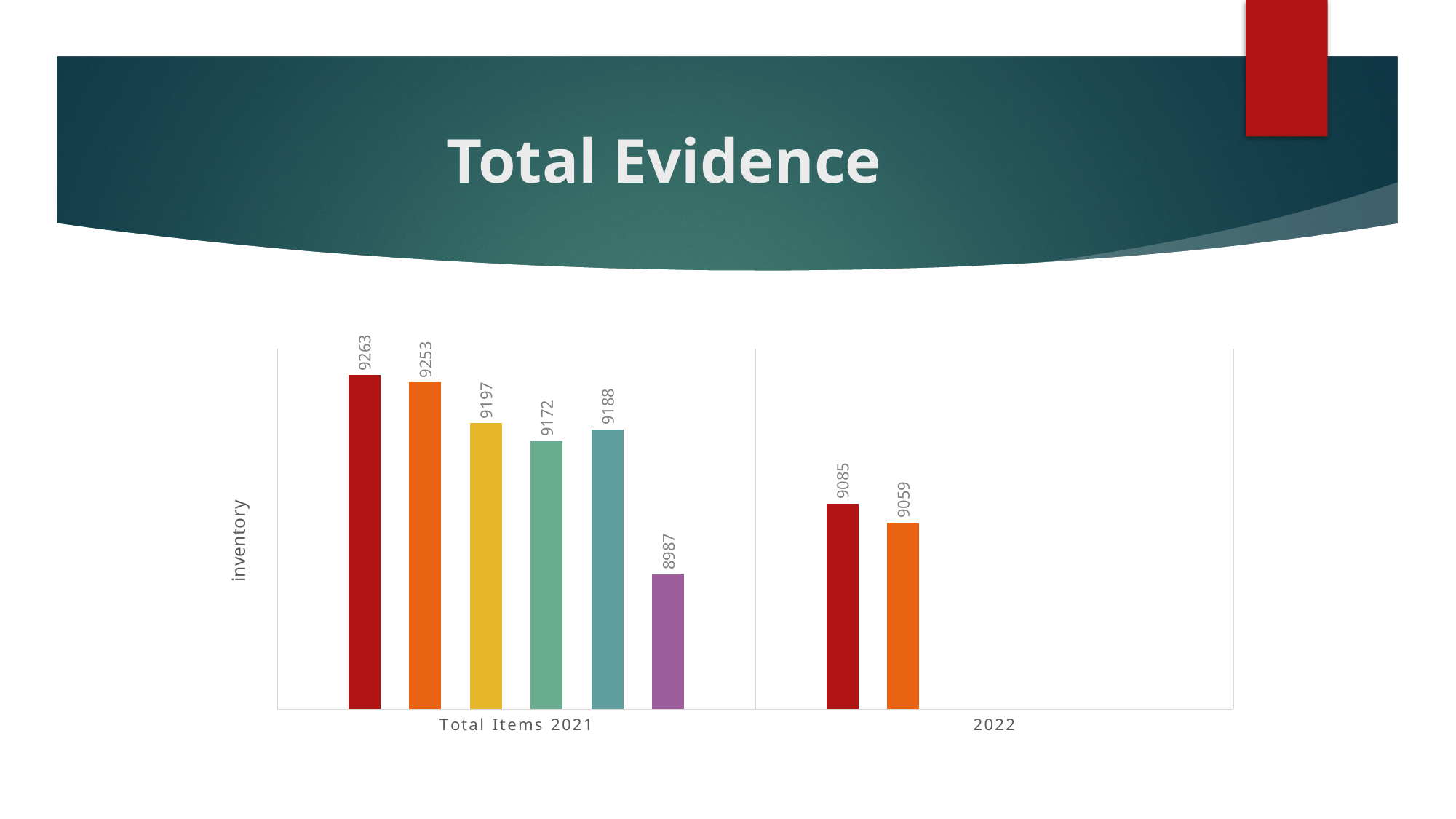
What is the label on the vertical axis? inventory What is the value of the orange bar in the 2022 group? 9059 What is the difference between the highest and lowest bars in the Total Items 2021 group? 276 Which is larger: the red bar in Total Items 2021 or the red bar in 2022? the red bar in Total Items 2021 What is the value of the purple bar in the Total Items 2021 group? 8987 What kind of chart is shown on the slide? bar chart How many bars are plotted in the Total Items 2021 group? 6 What is the value of the first (red) bar in the Total Items 2021 group? 9263 What is the value of the red bar in the 2022 group? 9085 Which bar in the Total Items 2021 group has the highest value? the red bar (9263) What is the difference between the red bar and the orange bar in the 2022 group? 26 Which bar in the Total Items 2021 group has the lowest value? the purple bar (8987)